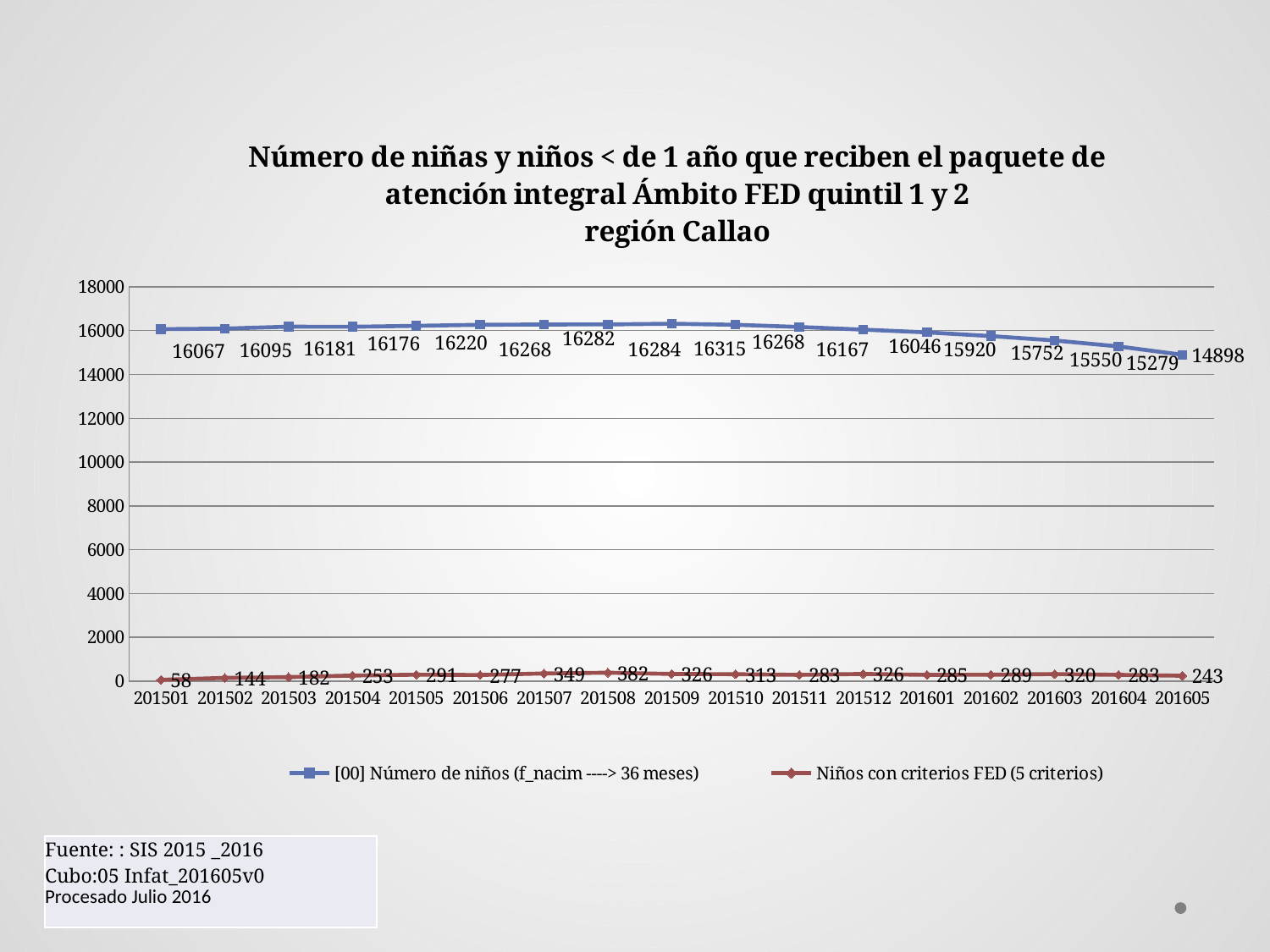
Which is larger: the 'Niños con criterios FED (5 criterios)' value for 201507 or for 201510? 201507 How many series does the legend list? 2 What type of chart is shown on the slide? line chart Does the series '[00] Número de niños (f_nacim ----> 36 meses)' rise or fall from 201509 to 201605? fall In which period does the series 'Niños con criterios FED (5 criterios)' reach its highest value? 201508 What is the value of the series '[00] Número de niños (f_nacim ----> 36 meses)' for 201509? 16315 What is the value of the series 'Niños con criterios FED (5 criterios)' for 201508? 382 What is the difference between the '[00] Número de niños' values for 201501 and 201605? 1169 Which region is named in the chart title? Callao How many time periods are plotted along the x axis? 17 In which period does the series '[00] Número de niños (f_nacim ----> 36 meses)' have its lowest value? 201605 What is the lowest value of the series 'Niños con criterios FED (5 criterios)'? 58